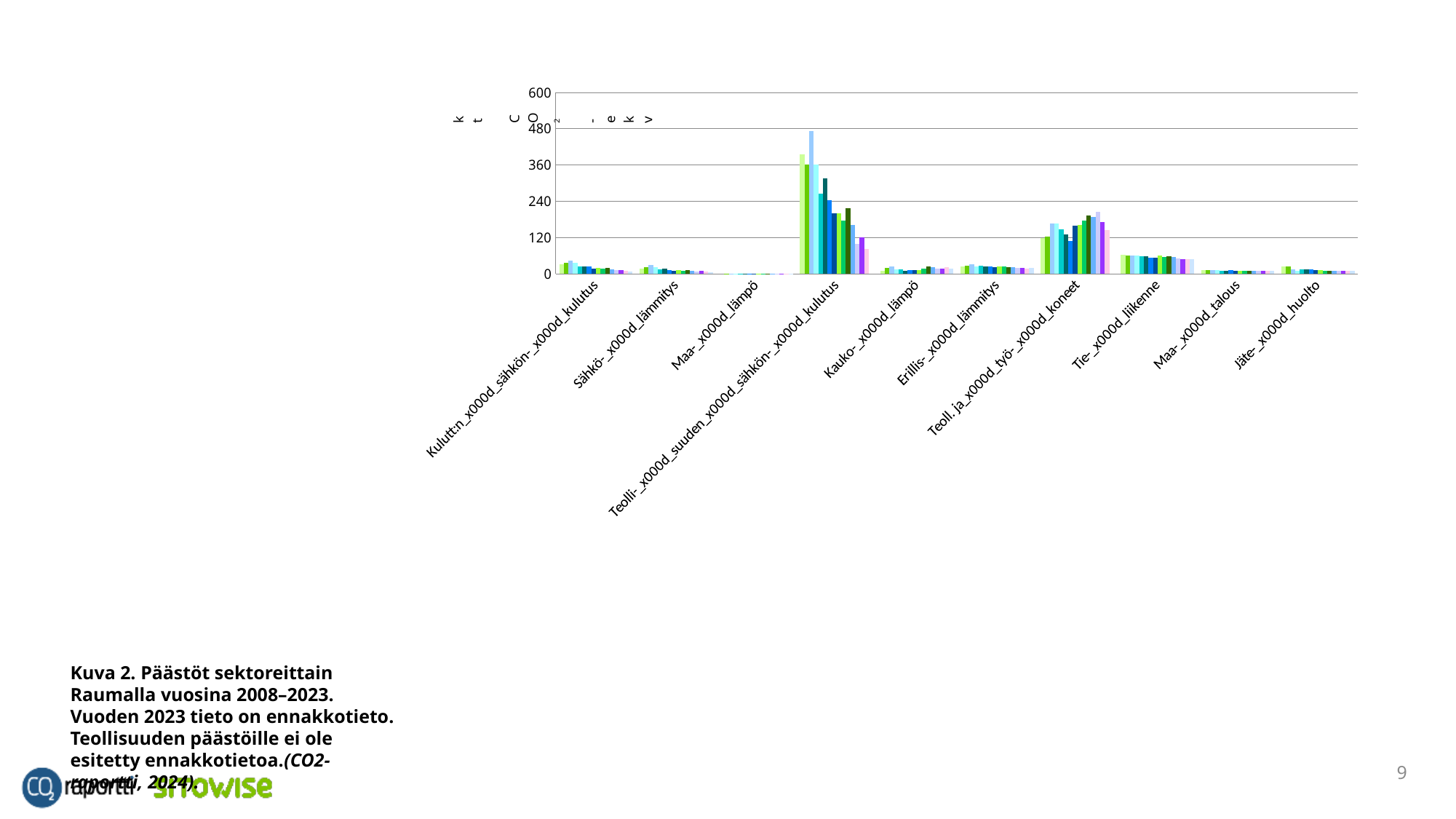
What is the highest value shown on the y axis of the chart? 600 Which category has taller bars, Kulutt:n_x000d_sähkön-_x000d_kulutus or Maa-_x000d_lämpö? Kulutt:n_x000d_sähkön-_x000d_kulutus What kind of chart is shown on the slide? bar chart Do the bars within the Teolli-_x000d_suuden_x000d_sähkön-_x000d_kulutus category generally rise or fall from left to right? fall How many categories are shown on the x axis of the chart? 10 Are the bars for Tie-_x000d_liikenne greater or less than 120? less Is the tallest bar in the Teoll. ja_x000d_työ-_x000d_koneet category greater or less than 240? less Which category has the tallest bars in the chart? Teolli-_x000d_suuden_x000d_sähkön-_x000d_kulutus Is the tallest bar in the Teolli-_x000d_suuden_x000d_sähkön-_x000d_kulutus category greater or less than 360? greater According to the caption, which years does the chart cover? 2008–2023 Which category has taller bars, Teoll. ja_x000d_työ-_x000d_koneet or Tie-_x000d_liikenne? Teoll. ja_x000d_työ-_x000d_koneet